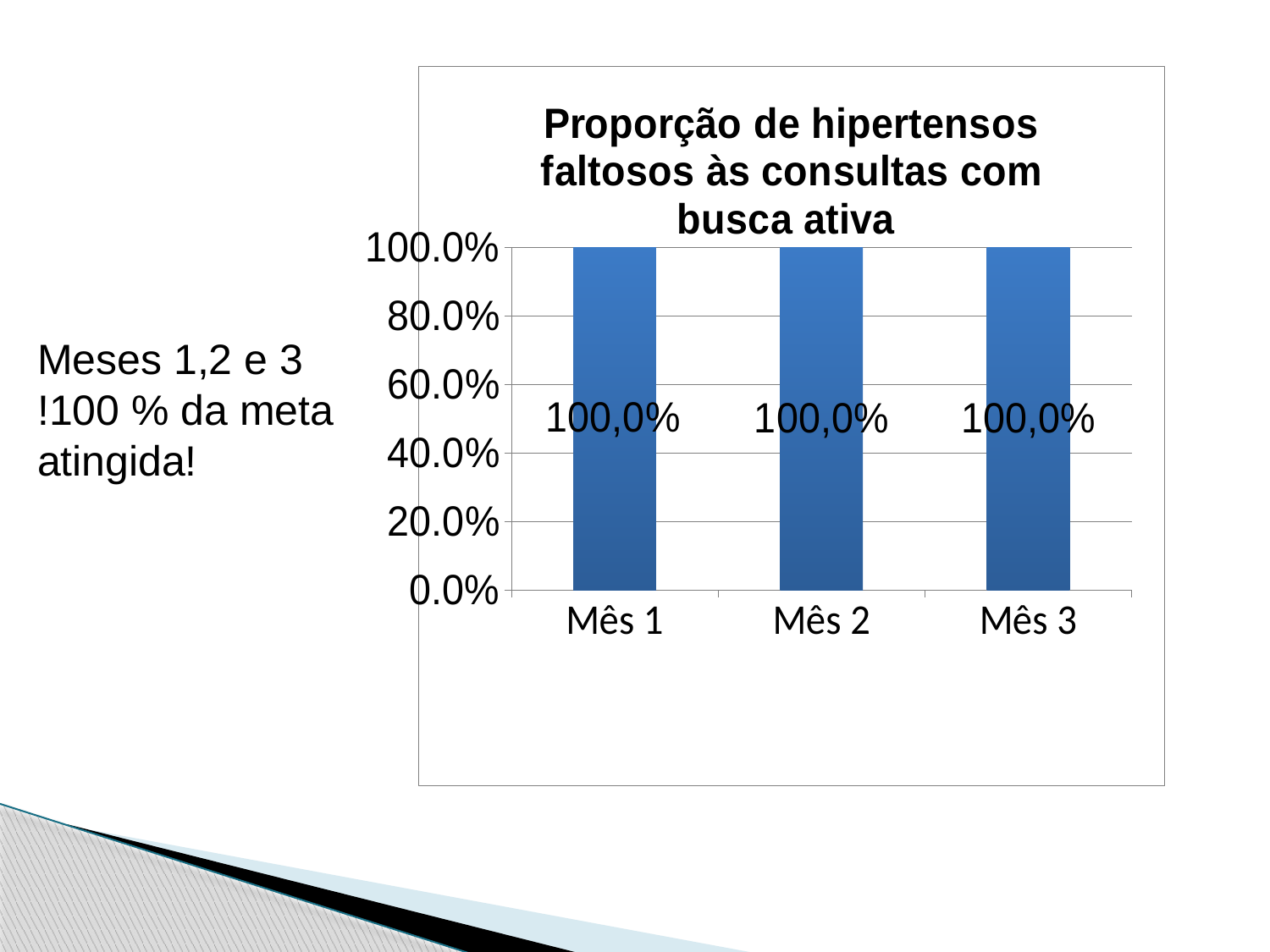
What is the value for Mês 1? 100,0% What colour are the bars in the chart? Blue What is the value for Mês 3? 100,0% Is the value for Mês 2 greater or less than 80.0%? greater What kind of chart is shown on the slide? Bar chart What is the title of the chart? Proporção de hipertensos faltosos às consultas com busca ativa What is the difference between the values for Mês 1 and Mês 3? 0,0% What is the highest value shown on the y axis? 100.0% How many categories are shown on the x axis? 3 Do the values rise, fall or stay the same from Mês 1 to Mês 3? Stay the same What is the value for Mês 2? 100,0%